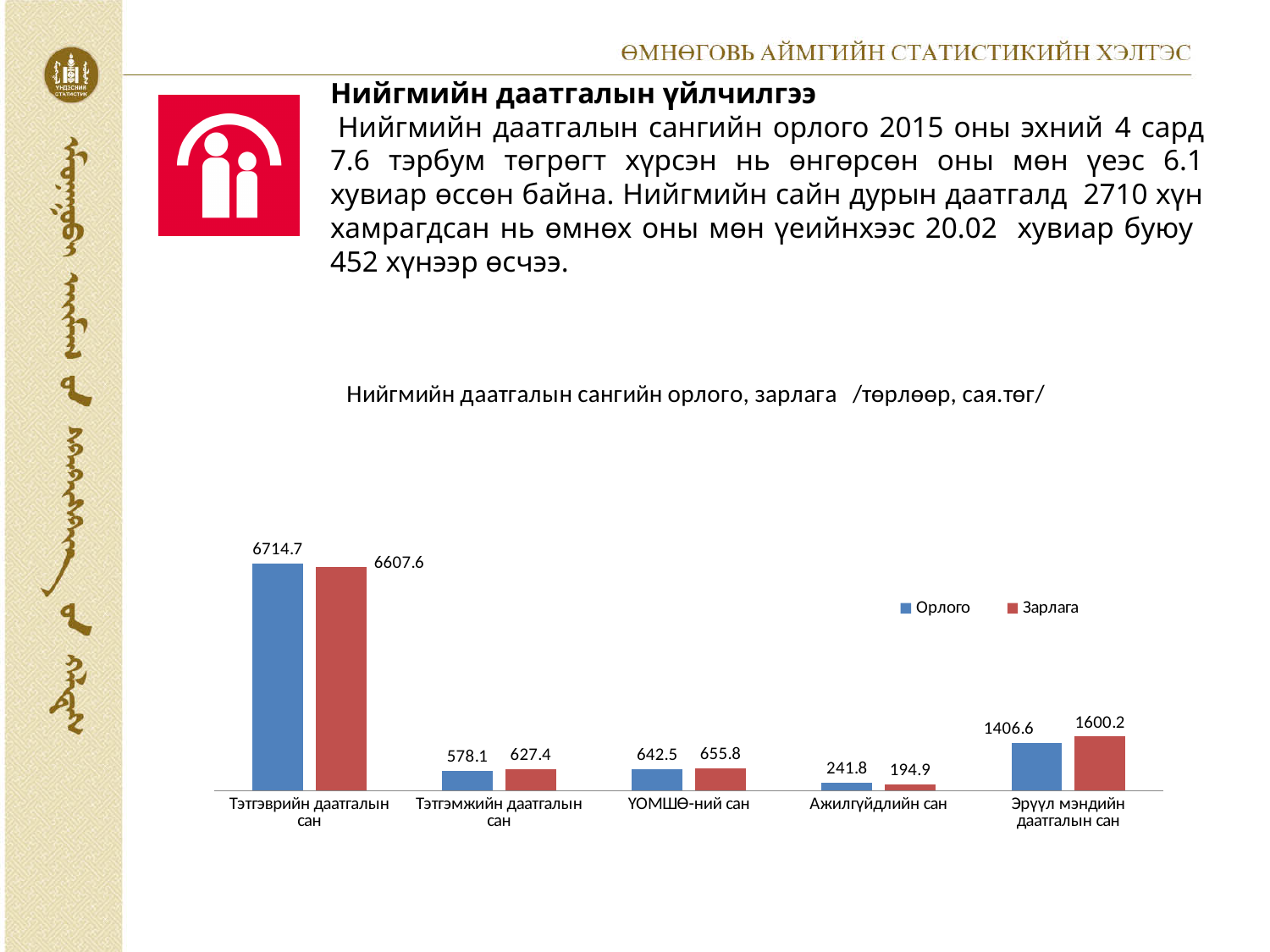
What is the Орлого value for Тэтгэврийн даатгалын сан? 6714.7 How many series does the legend list? 2 For Тэтгэмжийн даатгалын сан, which is larger, Орлого or Зарлага? Зарлага What is the difference between Зарлага and Орлого for Эрүүл мэндийн даатгалын сан? 193.6 What is the Зарлага value for Ажилгүйдлийн сан? 194.9 How many categories are shown on the x axis? 5 What kind of chart is shown on the slide? Bar chart Which category has the highest Орлого value? Тэтгэврийн даатгалын сан What is the Орлого value for ҮОМШӨ-ний сан? 642.5 What is the Зарлага value for Эрүүл мэндийн даатгалын сан? 1600.2 Which category has the lowest Зарлага value? Ажилгүйдлийн сан What is the difference between Орлого and Зарлага for Тэтгэврийн даатгалын сан? 107.1